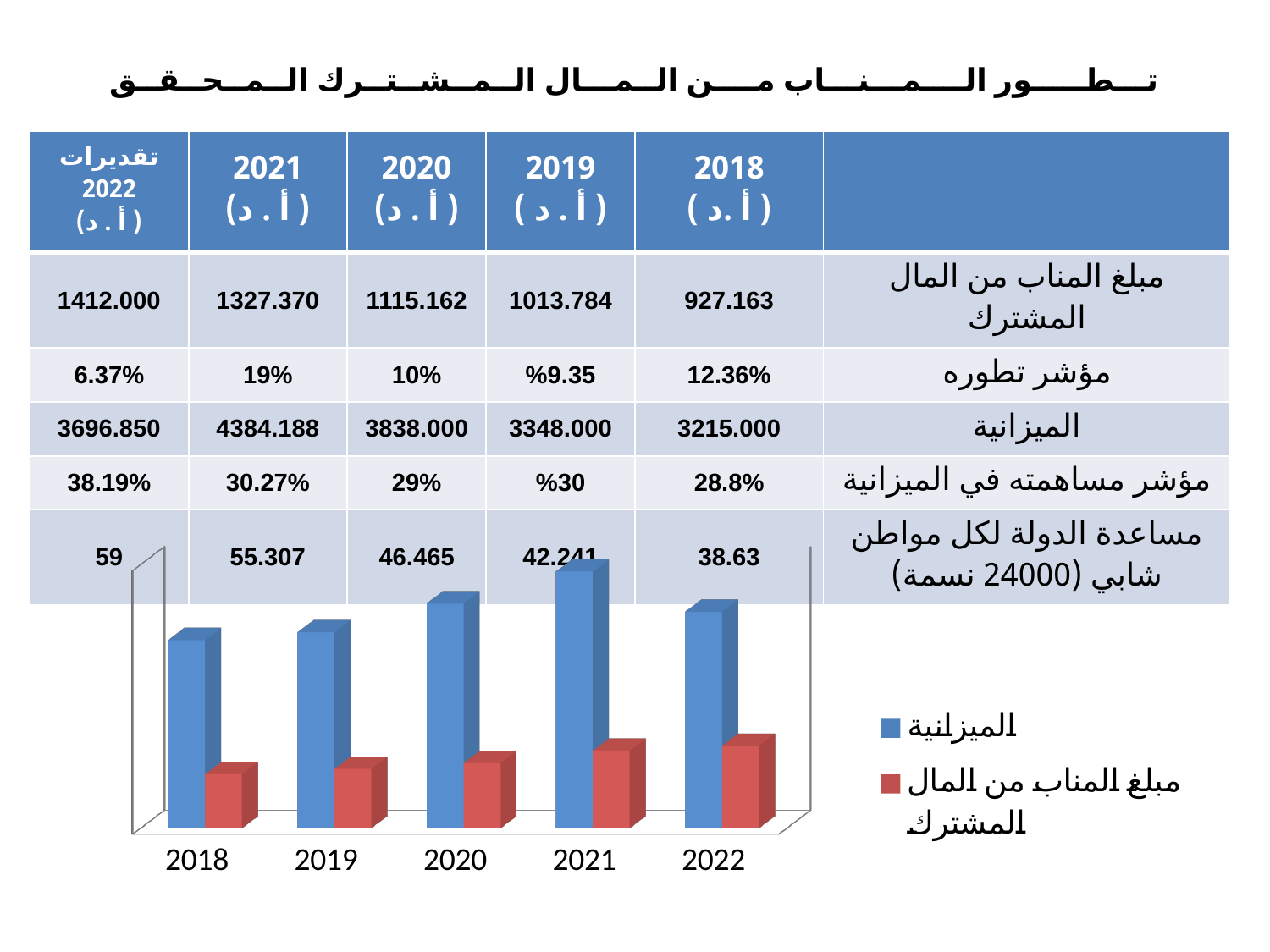
Which year has the tallest blue (الميزانية) bar in the chart? 2021 Which year has the shortest red (مبلغ المناب من المال المشترك) bar in the chart? 2018 Do the blue bars (الميزانية) rise or fall from 2018 to 2021? rise What kind of chart is shown on the slide? bar chart What is the first year shown on the x axis of the chart? 2018 In the chart, is the blue bar for 2021 taller or shorter than the blue bar for 2018? taller Which year has the shortest blue (الميزانية) bar in the chart? 2018 In the chart, for 2020, which series has the larger bar: الميزانية or مبلغ المناب من المال المشترك? الميزانية How many years are shown on the x axis of the chart? 5 Which series is shown in blue in the chart legend? الميزانية How many series does the chart legend list? 2 Do the red bars (مبلغ المناب من المال المشترك) rise or fall from 2018 to 2022? rise